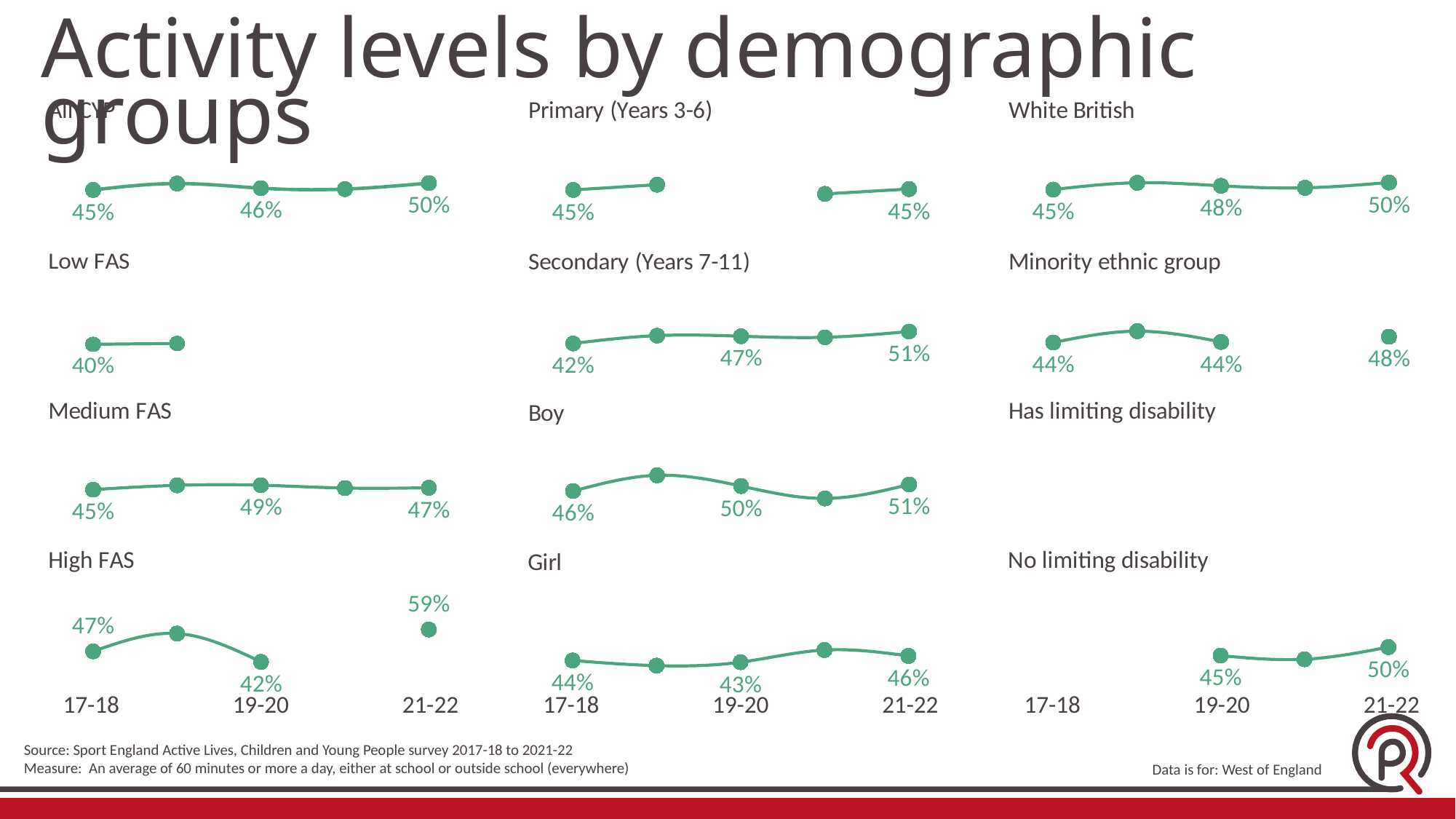
In the Girl chart, which is larger, the value for 17-18 or the value for 21-22? 21-22 How many data points are plotted in the Secondary (Years 7-11) chart? 5 In the High FAS chart, what is the value for 21-22? 59% In the Secondary (Years 7-11) chart, what is the value for 17-18? 42% In the Secondary (Years 7-11) chart, do the values rise or fall from 17-18 to 21-22? Rise In the Boy chart, what is the value for 19-20? 50% In the High FAS chart, which labelled year has the lowest value? 19-20 In the Medium FAS chart, which labelled year has the highest value? 19-20 In the Low FAS chart, what is the value for 17-18? 40% In the Minority ethnic group chart, what is the value for 21-22? 48% What type of chart is used for the Boy group? Line chart In the White British chart, what is the difference between the 21-22 value and the 17-18 value? 5%